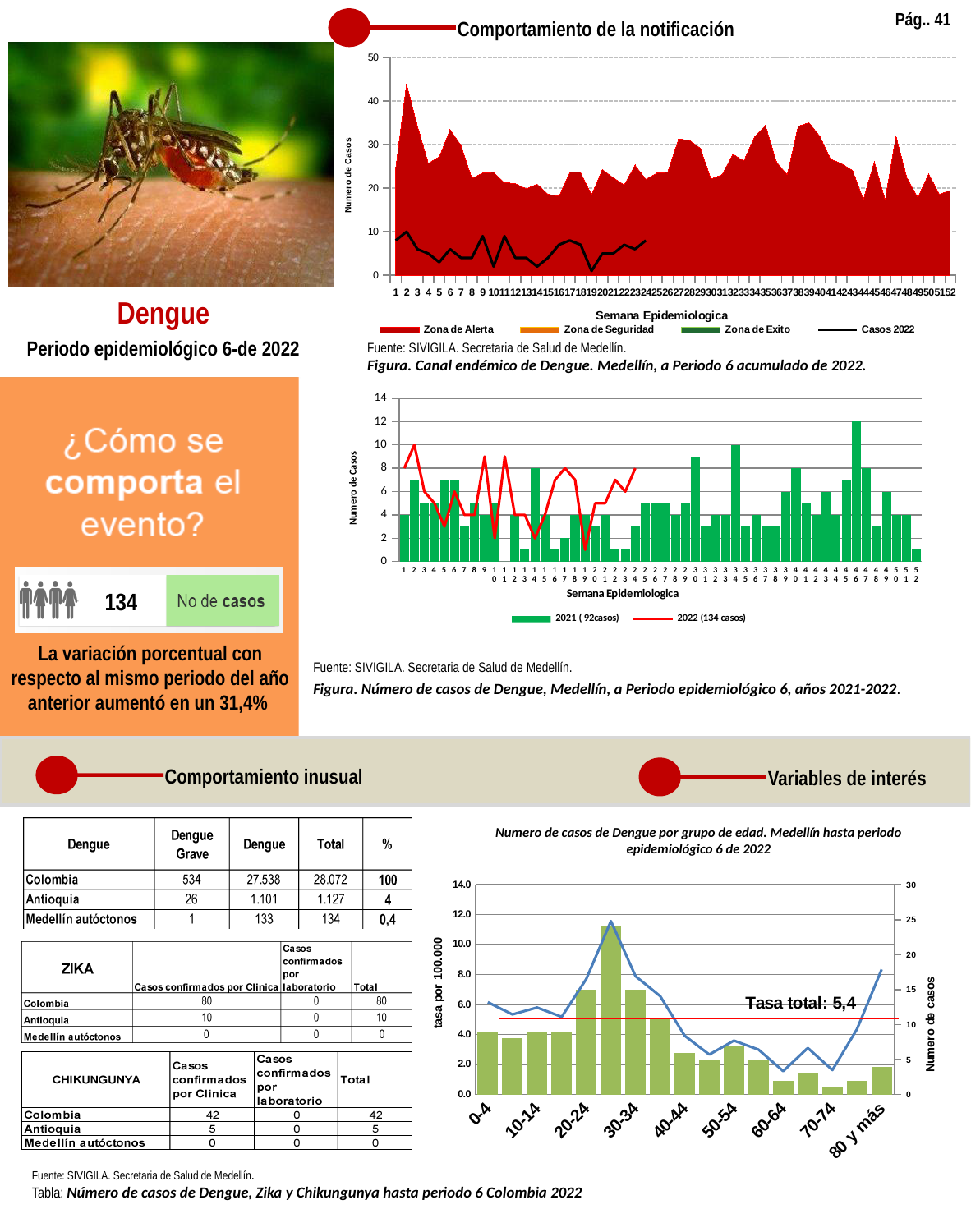
In the middle chart, which green 2021 bar is taller: week 1 or week 46? week 46 In the top chart (Canal endémico de Dengue), is the Zona de Alerta value at week 2 greater or less than 40? greater In the bottom-right chart, do the bars rise or fall from the 30-34 group to the 60-64 group? fall In the bottom-right chart (Numero de casos de Dengue por grupo de edad), what is the value shown for 'Tasa total'? 5,4 In the bottom-right chart, which bar is taller: 0-4 or 20-24? 20-24 In the top chart (Canal endémico de Dengue), what does the black line represent according to the legend? Casos 2022 In the middle chart, is the tallest green 2021 bar greater or less than 10? greater How many series does the legend of the top chart (Canal endémico de Dengue) list? 4 What kind of chart is the middle chart (Número de casos de Dengue, años 2021-2022)? combination bar and line chart How many series does the legend of the middle chart (Número de casos de Dengue, años 2021-2022) list? 2 According to the legend of the middle chart, how many cases does the 2022 series have? 134 casos